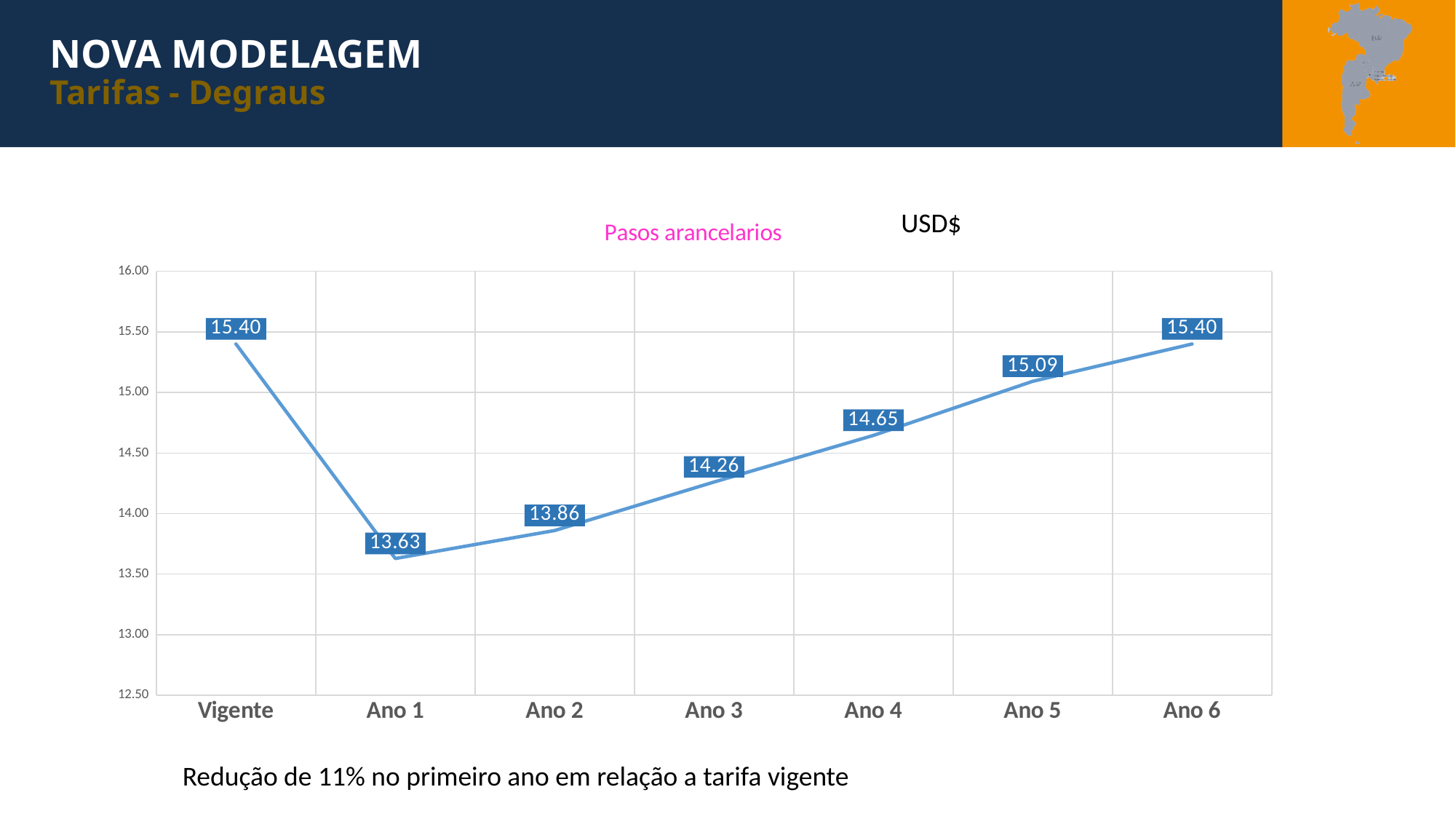
Do the values rise or fall from Ano 1 to Ano 6? rise What is the value for Ano 1? 13.63 Which is larger, the value for Ano 3 or the value for Ano 2? Ano 3 What is the title of the chart? Pasos arancelarios What is the value for Vigente? 15.40 What is the difference between the values for Ano 5 and Ano 4? 0.44 Which category has the lowest value? Ano 1 Is the value for Ano 5 greater or less than 15.00? greater What is the value for Ano 4? 14.65 How many categories are shown on the x axis? 7 What kind of chart is shown on the slide? line chart What is the difference between the values for Vigente and Ano 1? 1.77